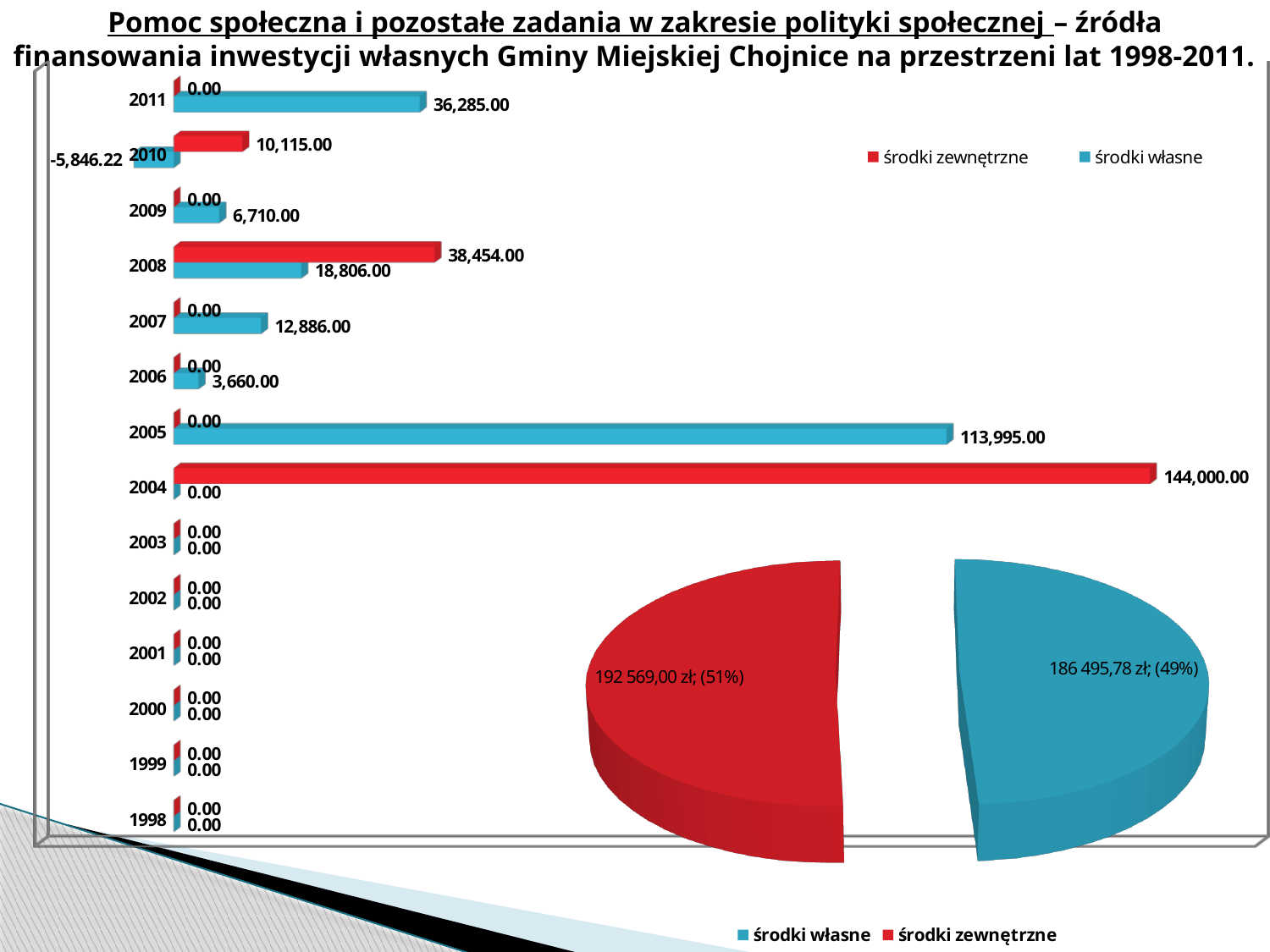
In the bar chart, what is the difference between środki zewnętrzne and środki własne in 2008? 19,648.00 In the bar chart, which year has the highest value of środki zewnętrzne? 2004 What kind of chart is the chart on the left side of the slide? bar chart In the pie chart, what share does środki zewnętrzne have? 51% In the bar chart, which is larger in 2008: środki zewnętrzne or środki własne? środki zewnętrzne In the bar chart, which year has the highest value of środki własne? 2005 How many years are shown in the bar chart? 14 In the pie chart, what is the value shown for środki własne? 186 495,78 zł In the bar chart, what is the value of środki własne for 2010? -5,846.22 How many series does the bar chart's legend list? 2 In the bar chart, what is the value of środki własne for 2011? 36,285.00 In the bar chart, what is the value of środki zewnętrzne for 2008? 38,454.00